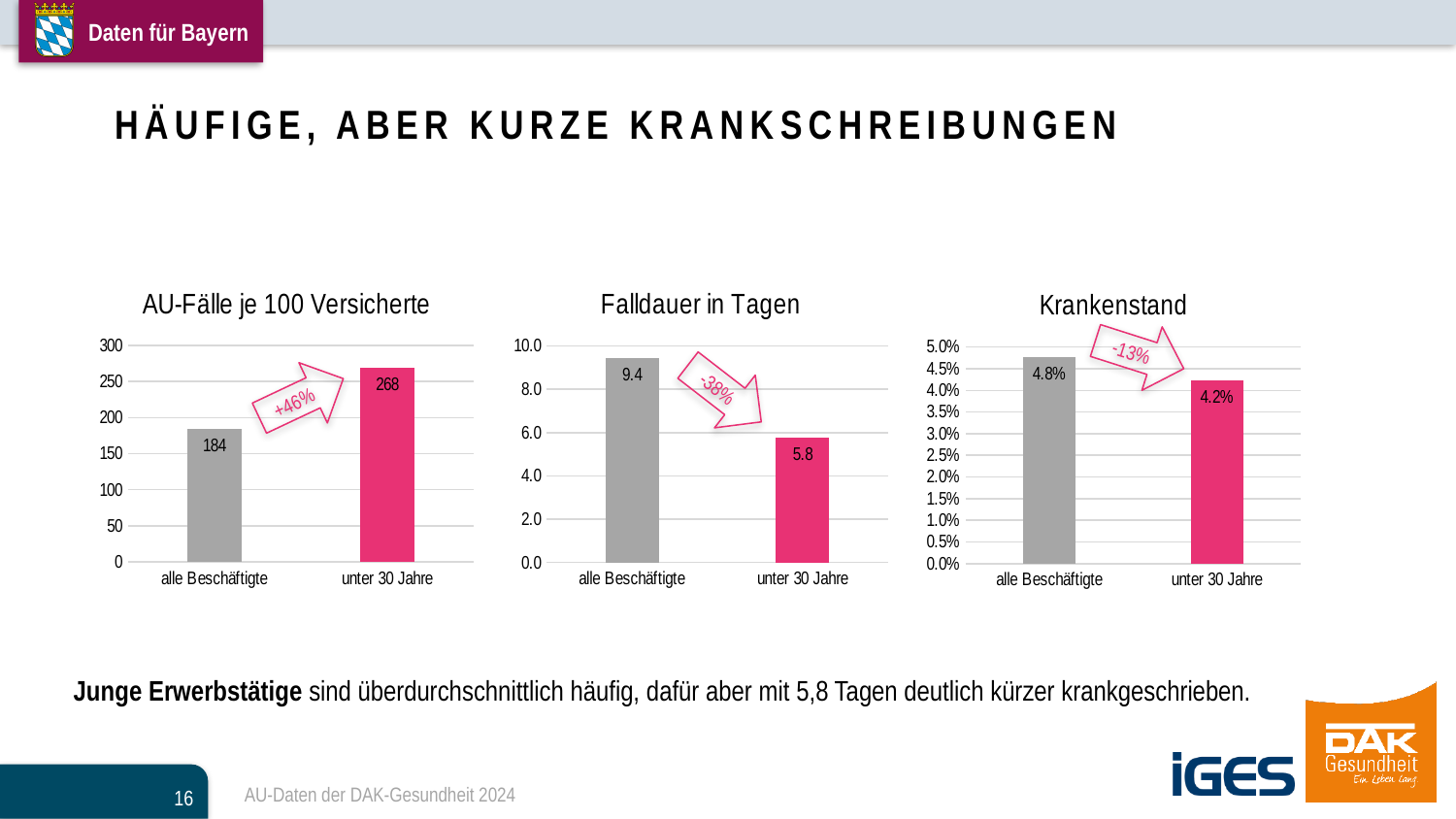
In the chart titled 'AU-Fälle je 100 Versicherte', what is the value for 'alle Beschäftigte'? 184 In the chart titled 'Krankenstand', what is the value for 'unter 30 Jahre'? 4.2% How many categories are shown in the chart titled 'Falldauer in Tagen'? 2 In the chart titled 'Falldauer in Tagen', which category has the higher value, 'alle Beschäftigte' or 'unter 30 Jahre'? alle Beschäftigte What kind of chart is the chart titled 'Krankenstand'? bar chart In the chart titled 'AU-Fälle je 100 Versicherte', what is the value for 'unter 30 Jahre'? 268 In the chart titled 'AU-Fälle je 100 Versicherte', is the value for 'alle Beschäftigte' greater or less than 200? less In the chart titled 'Krankenstand', which category has the lowest value? unter 30 Jahre In the chart titled 'Krankenstand', what is the value for 'alle Beschäftigte'? 4.8% In the chart titled 'Falldauer in Tagen', what is the value for 'unter 30 Jahre'? 5.8 In the chart titled 'Falldauer in Tagen', what is the value for 'alle Beschäftigte'? 9.4 In the chart titled 'AU-Fälle je 100 Versicherte', what is the difference between the values for 'unter 30 Jahre' and 'alle Beschäftigte'? 84